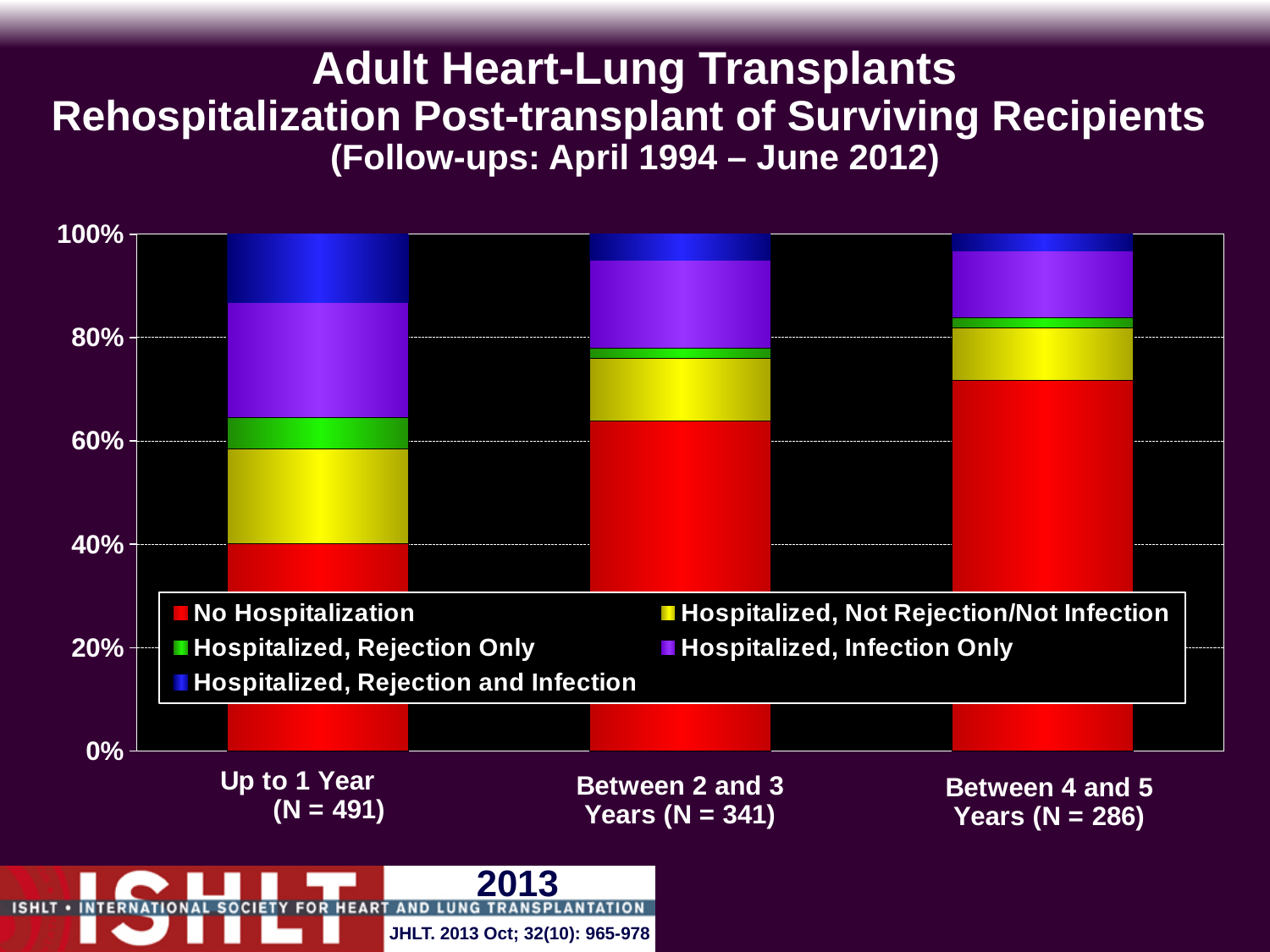
What is the total of the stacked bar for Up to 1 Year? 100% Is the No Hospitalization value for Between 2 and 3 Years greater or less than 60%? greater Which category has the smallest No Hospitalization segment? Up to 1 Year What is the N for the Between 2 and 3 Years category? 341 Which category has the largest No Hospitalization segment? Between 4 and 5 Years Is the No Hospitalization value for Between 4 and 5 Years greater or less than 80%? less Does the No Hospitalization share rise or fall from Up to 1 Year to Between 4 and 5 Years? Rise How many categories (time periods) are shown on the x axis? 3 Which category has the larger Hospitalized, Rejection Only segment: Up to 1 Year or Between 4 and 5 Years? Up to 1 Year Is the No Hospitalization value for Up to 1 Year greater or less than 60%? less What kind of chart is shown on the slide? Stacked bar chart How many series does the legend list? 5